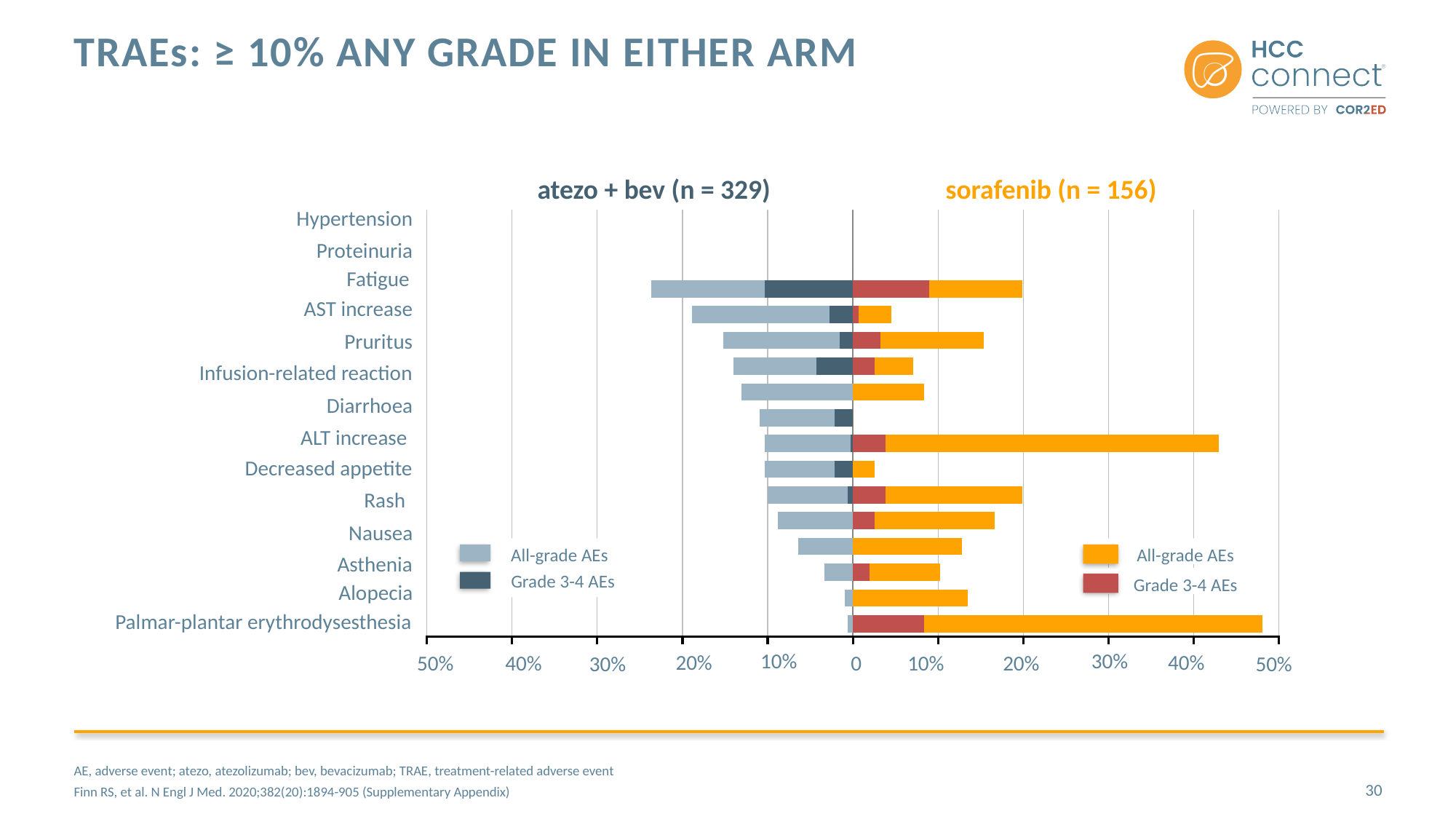
Is the atezo + bev all-grade AE rate for Palmar-plantar erythrodysesthesia greater or less than 10%? less What is the sample size shown for the sorafenib arm? n = 156 Is the sorafenib grade 3-4 AE rate for Palmar-plantar erythrodysesthesia greater or less than 20%? less How many entries does the sorafenib legend list? 2 What colour are the sorafenib all-grade AE bars? orange For Palmar-plantar erythrodysesthesia, which arm has the higher all-grade AE rate, atezo + bev or sorafenib? sorafenib Is the sorafenib all-grade AE rate for Palmar-plantar erythrodysesthesia greater or less than 40%? greater How many entries does the atezo + bev legend list? 2 Which category has the longest sorafenib all-grade AE bar? Palmar-plantar erythrodysesthesia How many adverse event categories are listed on the chart? 14 What kind of chart is shown on the slide? bar chart